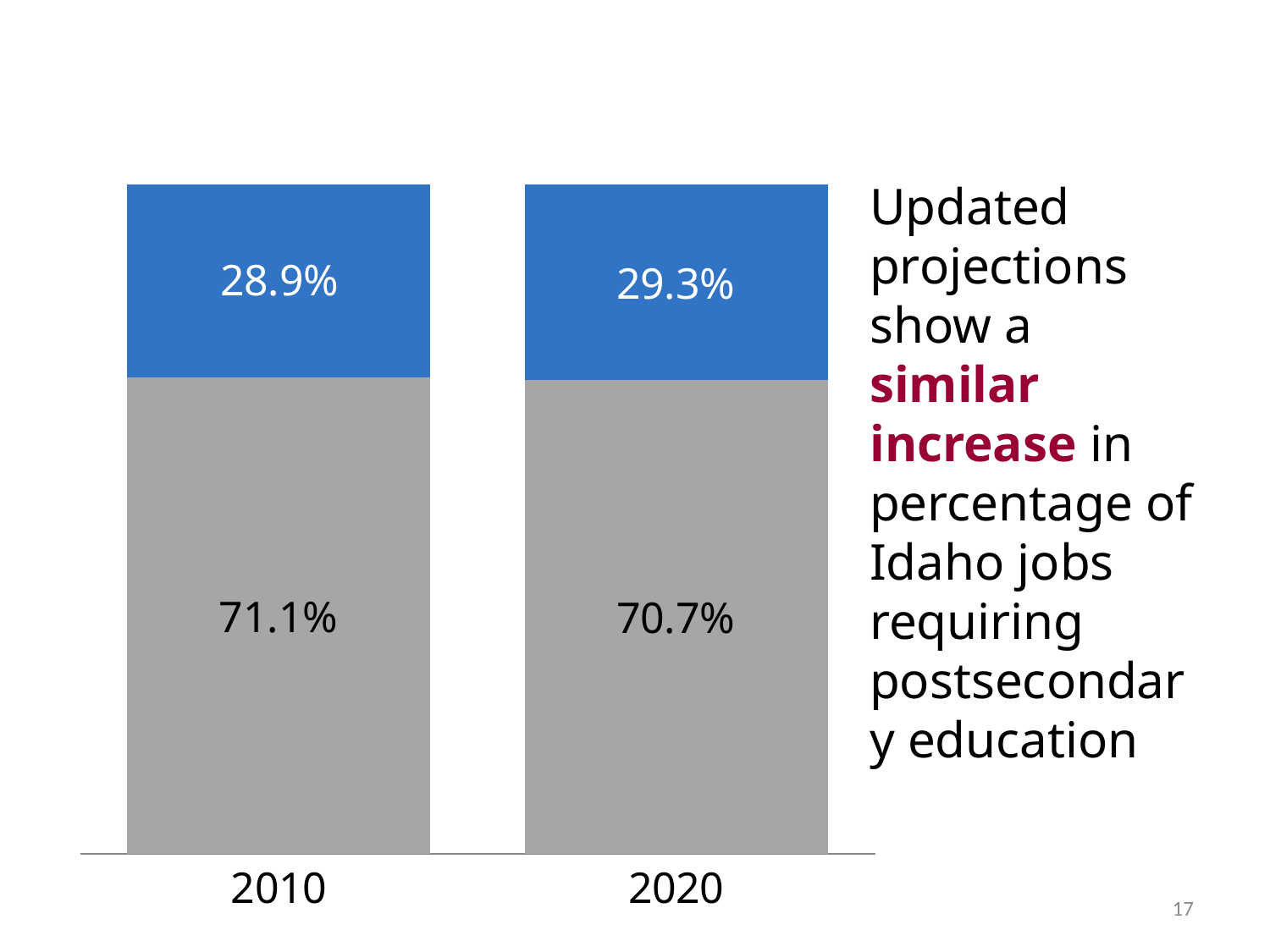
What value is shown in the grey segment of the 2020 bar? 70.7% What kind of chart is shown on the slide? Stacked bar chart What value is shown in the grey segment of the 2010 bar? 71.1% What value is shown in the blue segment of the 2010 bar? 28.9% What value is shown in the blue segment of the 2020 bar? 29.3% How many bars are shown on the chart? 2 Which year has the larger blue segment, 2010 or 2020? 2020 By how many percentage points does the grey segment change from 2010 to 2020? 0.4 percentage points Which year has the larger grey segment, 2010 or 2020? 2010 By how many percentage points does the blue segment change from 2010 to 2020? 0.4 percentage points Does the blue segment rise or fall from 2010 to 2020? Rise What is the total of the two segments in the 2010 bar? 100.0%